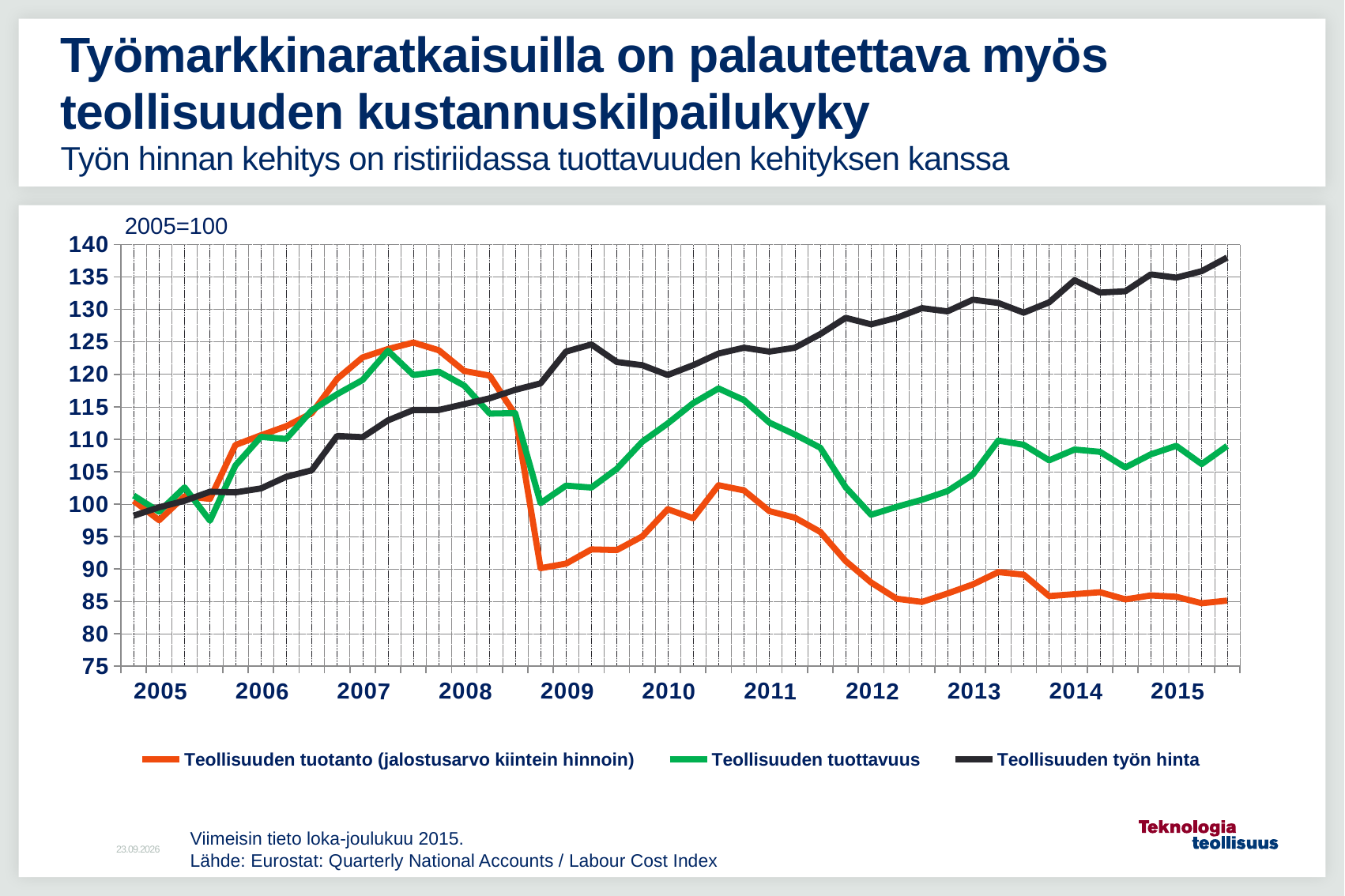
What kind of chart is shown on the slide? line chart Which series is shown with the black line? Teollisuuden työn hinta How many series does the legend list? 3 Does Teollisuuden työn hinta rise or fall overall from 2005 to 2015? rise Is the value for Teollisuuden tuottavuus at the end of 2015 greater or less than 105? greater Is the value for Teollisuuden tuotanto (jalostusarvo kiintein hinnoin) at the end of 2015 greater or less than 90? less Is the value for Teollisuuden tuotanto (jalostusarvo kiintein hinnoin) at the start of 2009 greater or less than 95? less Which series has the highest value at the end of 2015? Teollisuuden työn hinta How many year labels are shown on the x axis? 11 What base-year note is printed above the chart? 2005=100 Which series has the lowest value at the end of 2015? Teollisuuden tuotanto (jalostusarvo kiintein hinnoin)